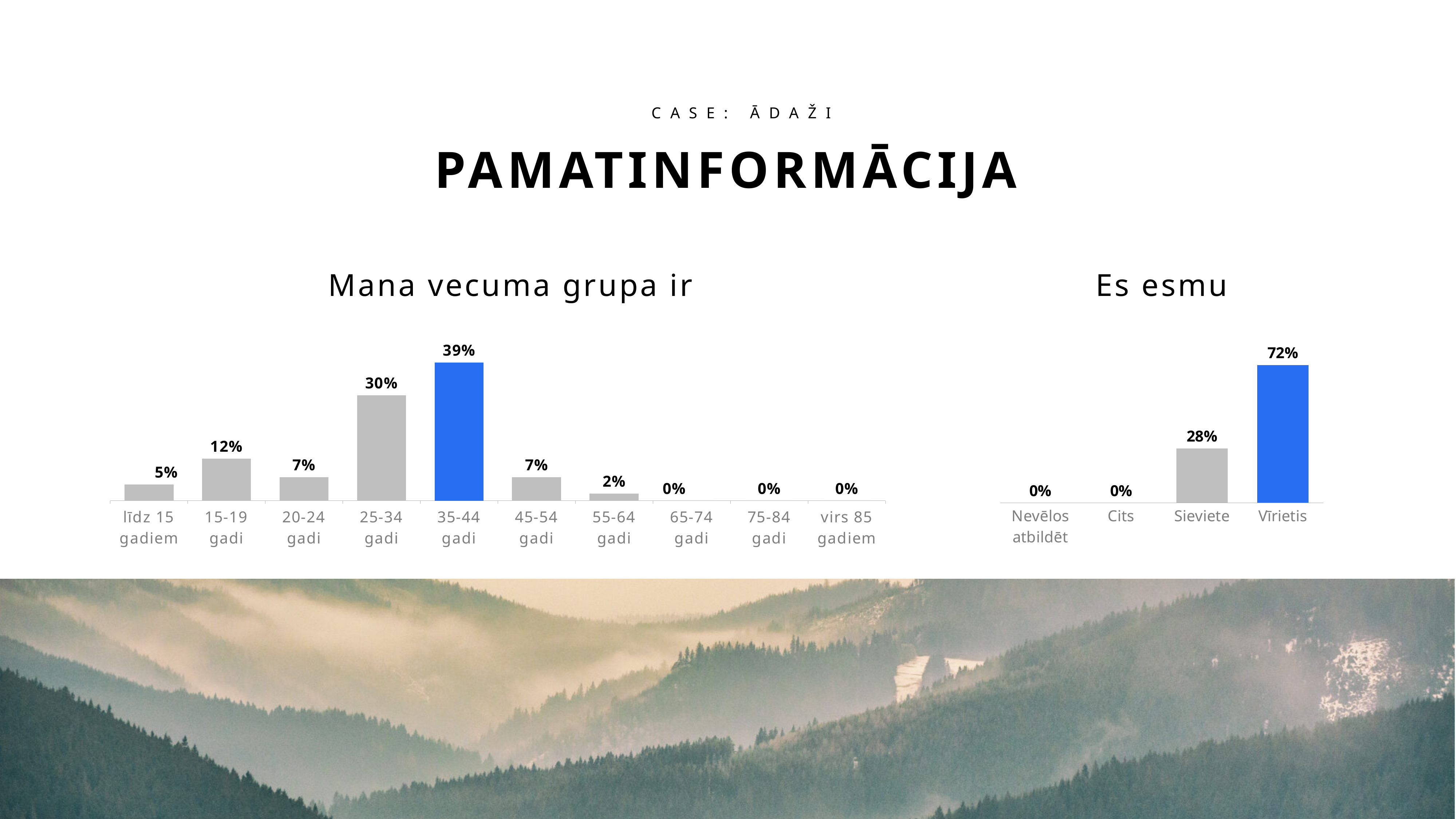
In the 'Es esmu' chart, what is the difference between the values for Vīrietis and Sieviete? 44% In the 'Mana vecuma grupa ir' chart, what is the value for 35-44 gadi? 39% In the 'Mana vecuma grupa ir' chart, what is the value for 55-64 gadi? 2% In the 'Mana vecuma grupa ir' chart, what is the value for 25-34 gadi? 30% In the 'Mana vecuma grupa ir' chart, which is larger, the value for 15-19 gadi or the value for 20-24 gadi? 15-19 gadi In the 'Es esmu' chart, what is the value for Sieviete? 28% In the 'Mana vecuma grupa ir' chart, what is the difference between the values for 35-44 gadi and 25-34 gadi? 9% How many age groups are shown in the 'Mana vecuma grupa ir' chart? 10 In the 'Es esmu' chart, what is the value for Vīrietis? 72% In the 'Mana vecuma grupa ir' chart, which age group has the highest value? 35-44 gadi In the 'Es esmu' chart, which category's bar is coloured blue? Vīrietis What kind of chart is the 'Es esmu' chart? Bar chart